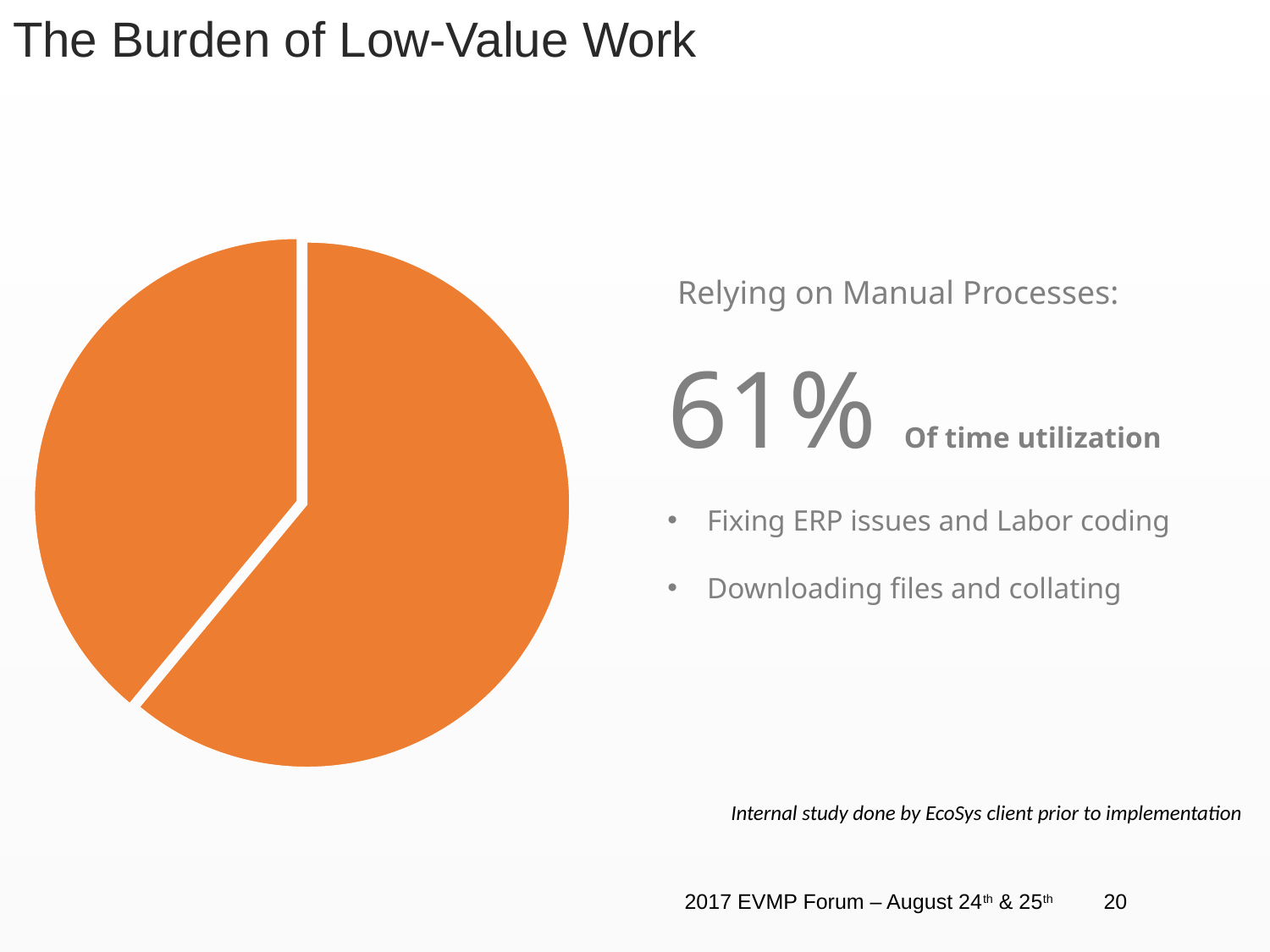
Is the larger slice of the pie greater or less than 50% of the whole? greater Is the smaller slice of the pie (upper left) greater or less than 50% of the whole? less Which slice is larger: the slice on the upper left or the slice covering the right and bottom of the pie? the slice covering the right and bottom What colour are the slices of the pie chart? orange What kind of chart is shown on the slide? pie chart What is the title of the slide containing the pie chart? The Burden of Low-Value Work How many slices does the pie chart have? 2 What share of the pie does the larger slice represent, according to the figure printed on the slide? 61%